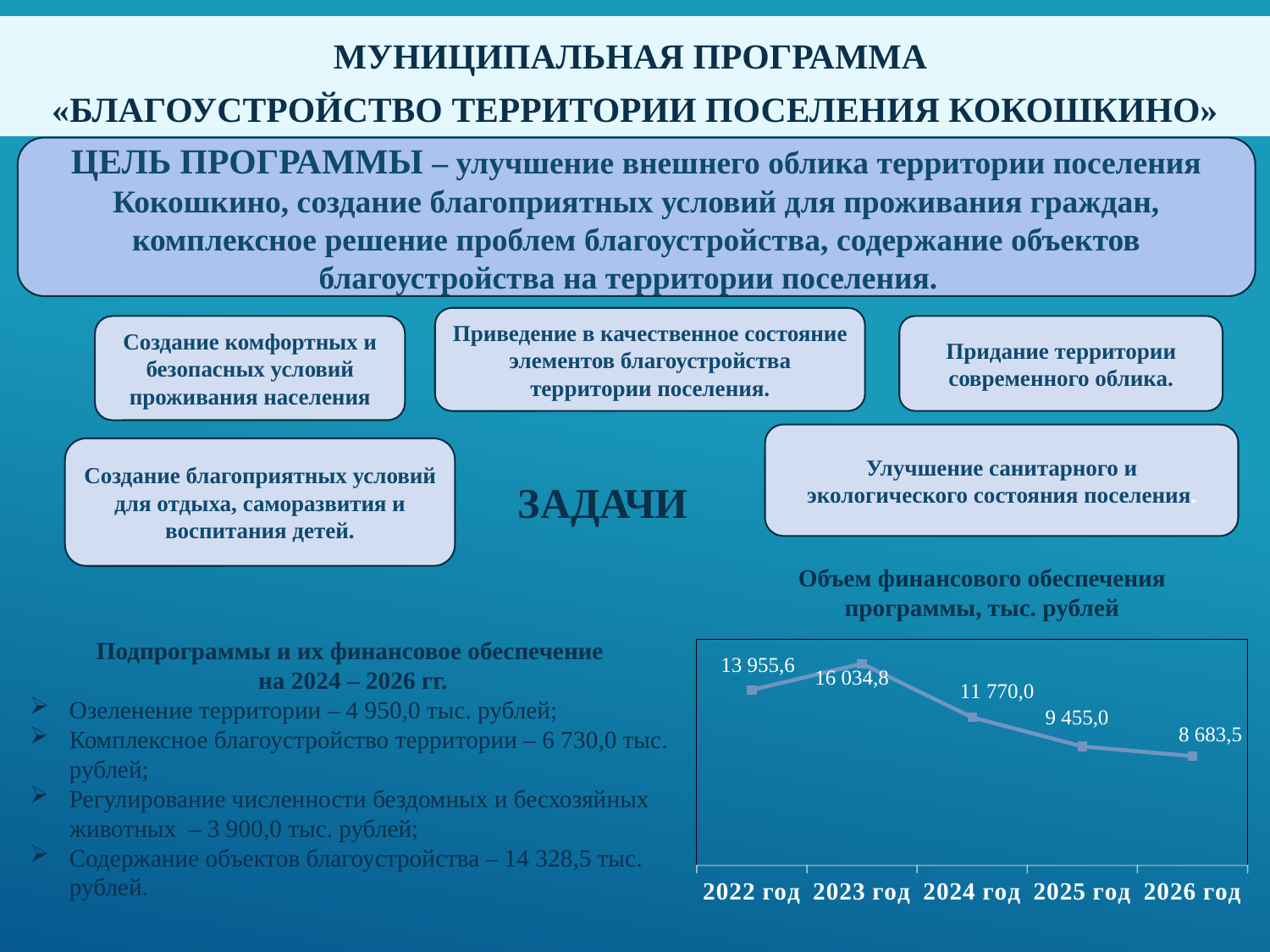
What is the value for 2025 год on the chart? 9 455,0 What is the value for 2026 год on the chart? 8 683,5 Which year has the lowest value on the chart? 2026 год What is the value for 2022 год on the chart? 13 955,6 What is the value for 2024 год on the chart? 11 770,0 What is the value for 2023 год on the chart? 16 034,8 Which year has the highest value on the chart? 2023 год How many years are plotted on the chart? 5 Which is larger, the value for 2022 год or the value for 2024 год? 2022 год What is the difference between the values for 2023 год and 2022 год? 2 079,2 What is the difference between the values for 2024 год and 2025 год? 2 315,0 What kind of chart is shown on the slide? Line chart